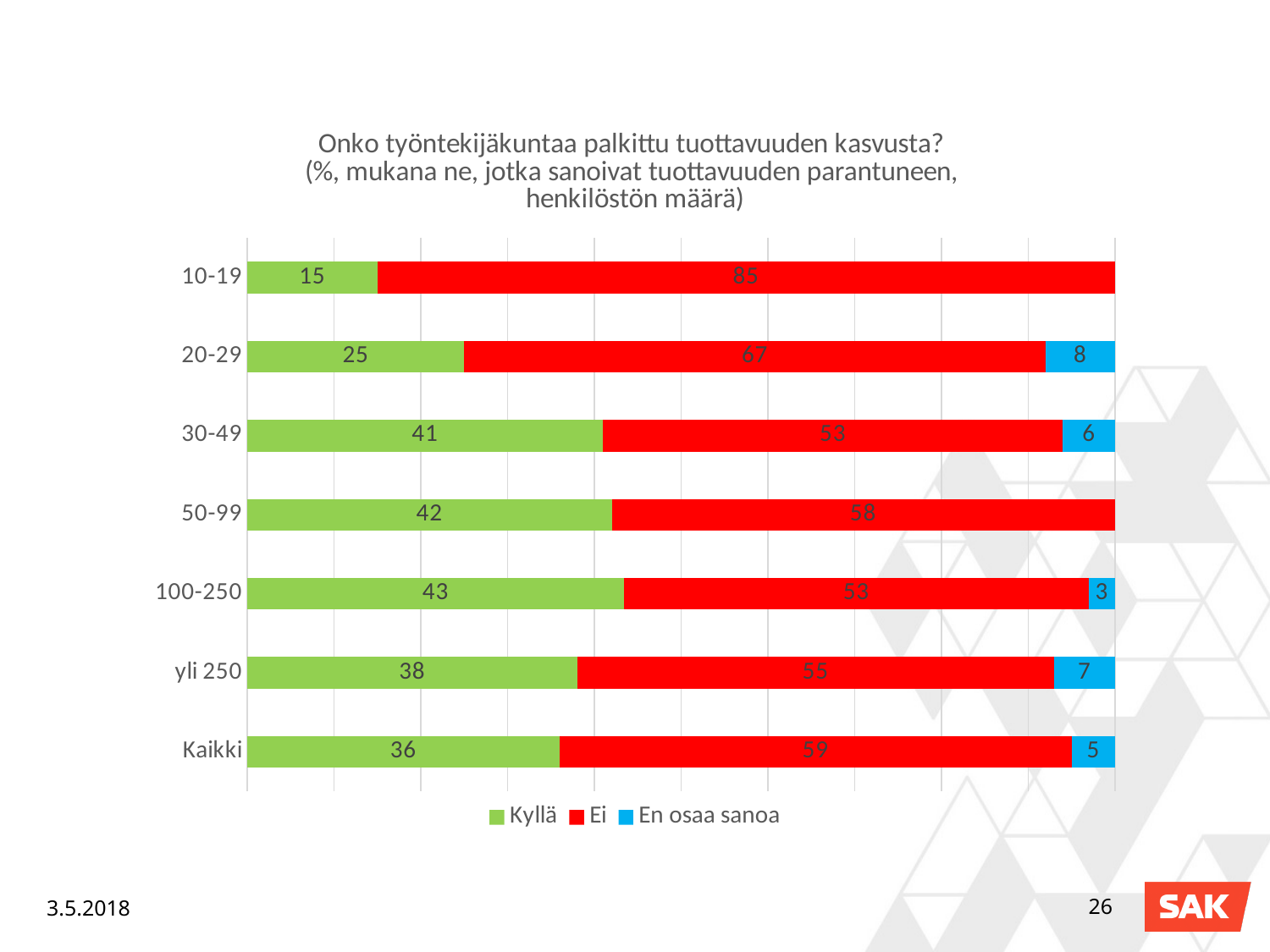
What is the total of the stacked bar for the 100-250 category? 99 What is the Kyllä value for the 10-19 category? 15 Which category has the highest Ei value? 10-19 What is the En osaa sanoa value for the yli 250 category? 7 Which colour represents the Ei series in the legend? Red How many categories are shown on the vertical axis? 7 How many series does the legend list? 3 What kind of chart is shown on the slide? Stacked bar chart What is the Ei value for the 20-29 category? 67 Which is larger, the Kyllä value for 30-49 or the Kyllä value for 20-29? 30-49 What is the difference between the Ei value and the Kyllä value for the Kaikki category? 23 Which category has the lowest Kyllä value? 10-19